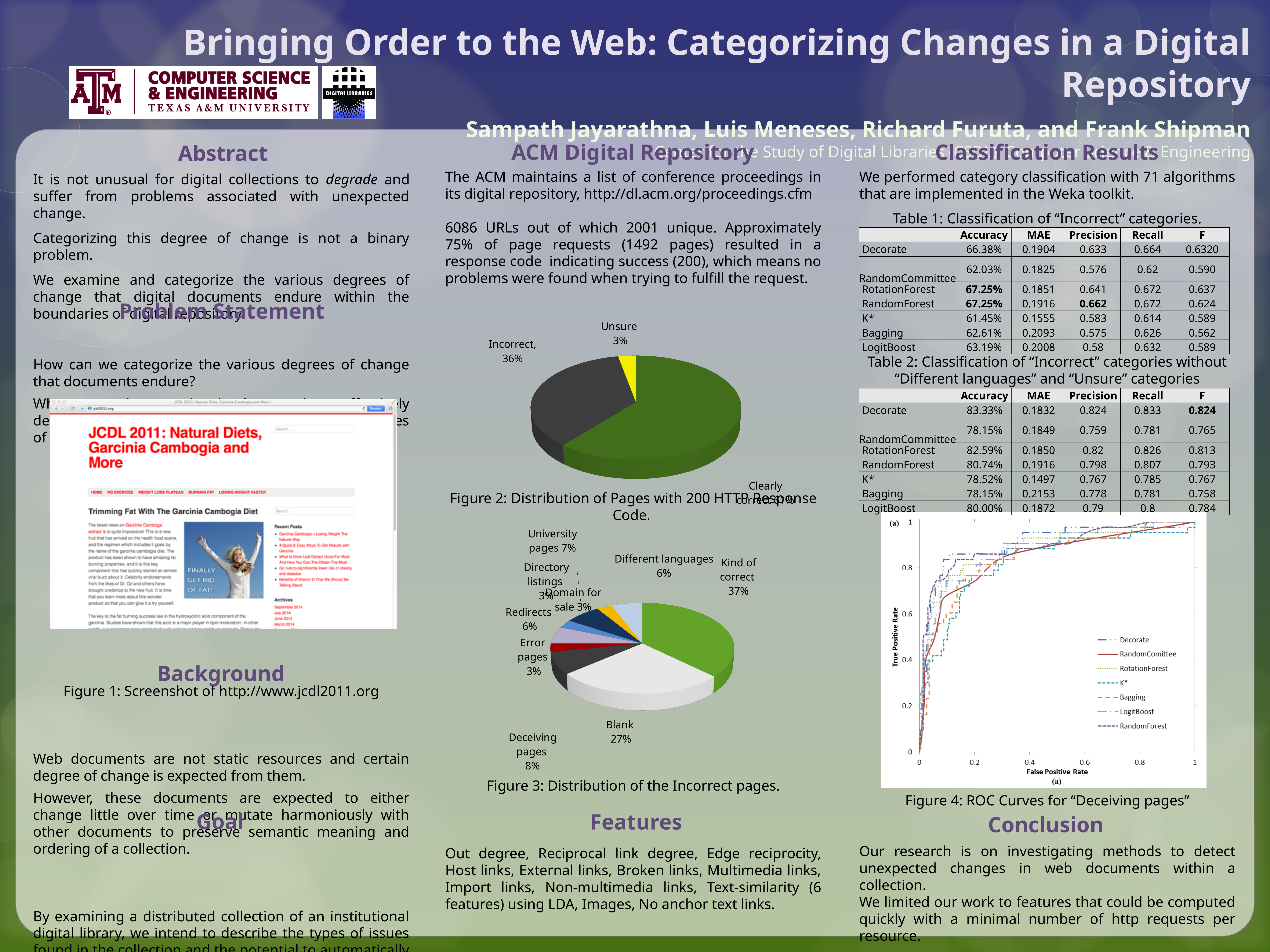
In Figure 3 (Distribution of the Incorrect pages), how many percentage points larger is 'Kind of correct' than 'Blank'? 10 percentage points What is the x-axis label of Figure 4 (ROC Curves for 'Deceiving pages')? False Positive Rate What kind of chart is Figure 2, 'Distribution of Pages with 200 HTTP Response Code'? pie chart In Figure 2 (Distribution of Pages with 200 HTTP Response Code), which slice is smallest? Unsure In Figure 3 (Distribution of the Incorrect pages), which category has the largest slice? Kind of correct In Figure 3 (Distribution of the Incorrect pages), what percentage is 'Kind of correct'? 37% In Figure 2 (Distribution of Pages with 200 HTTP Response Code), what share of pages is labelled Unsure? 3% How many series does the legend of Figure 4 (ROC Curves for 'Deceiving pages') list? 7 In Figure 2 (Distribution of Pages with 200 HTTP Response Code), what share of pages is labelled Incorrect? 36% How many categories are shown in the Figure 3 pie chart (Distribution of the Incorrect pages)? 9 In Figure 3 (Distribution of the Incorrect pages), what percentage is 'Blank'? 27% In Figure 3 (Distribution of the Incorrect pages), what percentage is 'Deceiving pages'? 8%